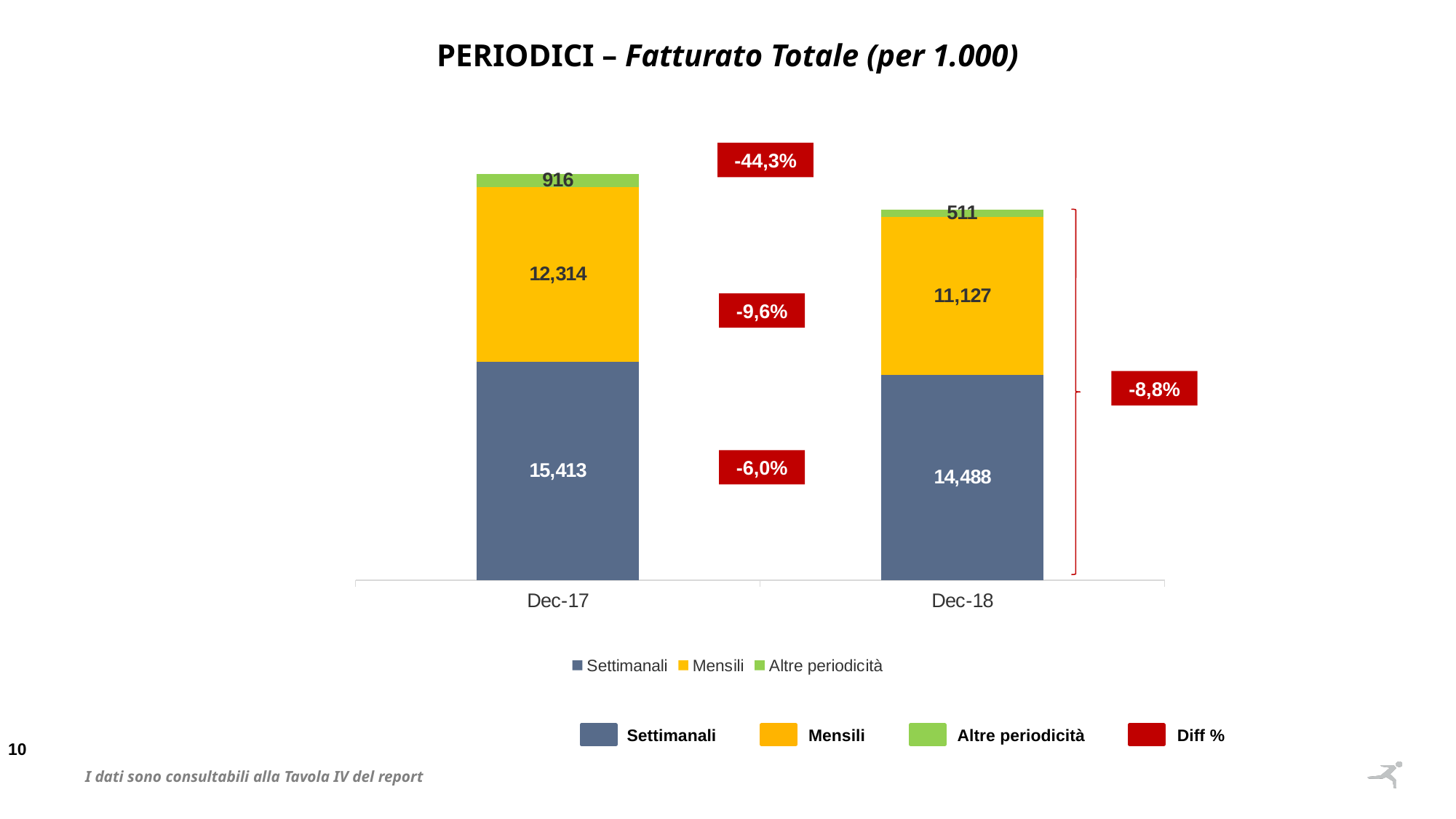
What is the value for Settimanali in Dec-18? 14,488 What is the total of the stacked bar for Dec-18? 26,126 What is the total of the stacked bar for Dec-17? 28,643 How many series does the chart legend below the x axis list? 3 What is the difference between the Mensili values for Dec-17 and Dec-18? 1,187 What kind of chart is shown on the slide? Stacked bar chart What is the value for Mensili in Dec-18? 11,127 What is the value for Settimanali in Dec-17? 15,413 Which series has the largest value in Dec-18? Settimanali What is the value for Altre periodicità in Dec-17? 916 What percentage change is shown for Altre periodicità between Dec-17 and Dec-18? -44,3% What is the overall percentage change shown for the total between Dec-17 and Dec-18? -8,8%